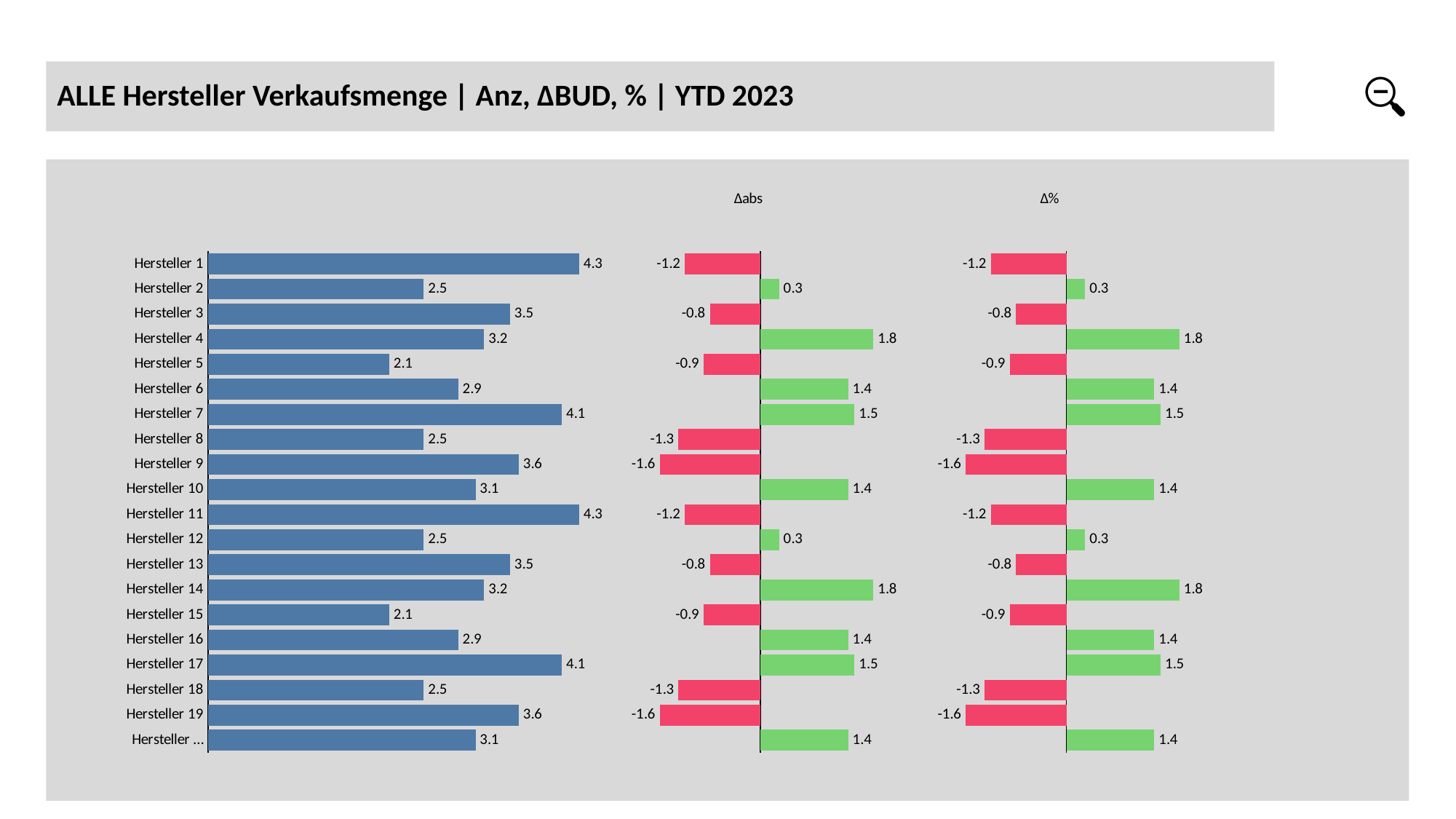
In the Δabs chart, what is the value for Hersteller 2? 0.3 In the left-hand bar chart, what is the value for Hersteller 7? 4.1 In the Δabs chart, what is the value for Hersteller 9? -1.6 In the left-hand bar chart, what is the difference between the values for Hersteller 1 and Hersteller 2? 1.8 In the Δ% chart, what colour are the bars with negative values? Red What kind of chart is the left-hand chart? Bar chart In the left-hand bar chart, which is larger, the value for Hersteller 3 or Hersteller 6? Hersteller 3 In the left-hand bar chart, what is the value for Hersteller 5? 2.1 In the Δ% chart, what is the value for Hersteller 4? 1.8 In the Δabs chart, what is the difference between the values for Hersteller 4 and Hersteller 6? 0.4 What is the title of the slide's chart area? ALLE Hersteller Verkaufsmenge | Anz, ΔBUD, % | YTD 2023 How many categories (Hersteller) are shown in the left-hand bar chart? 20